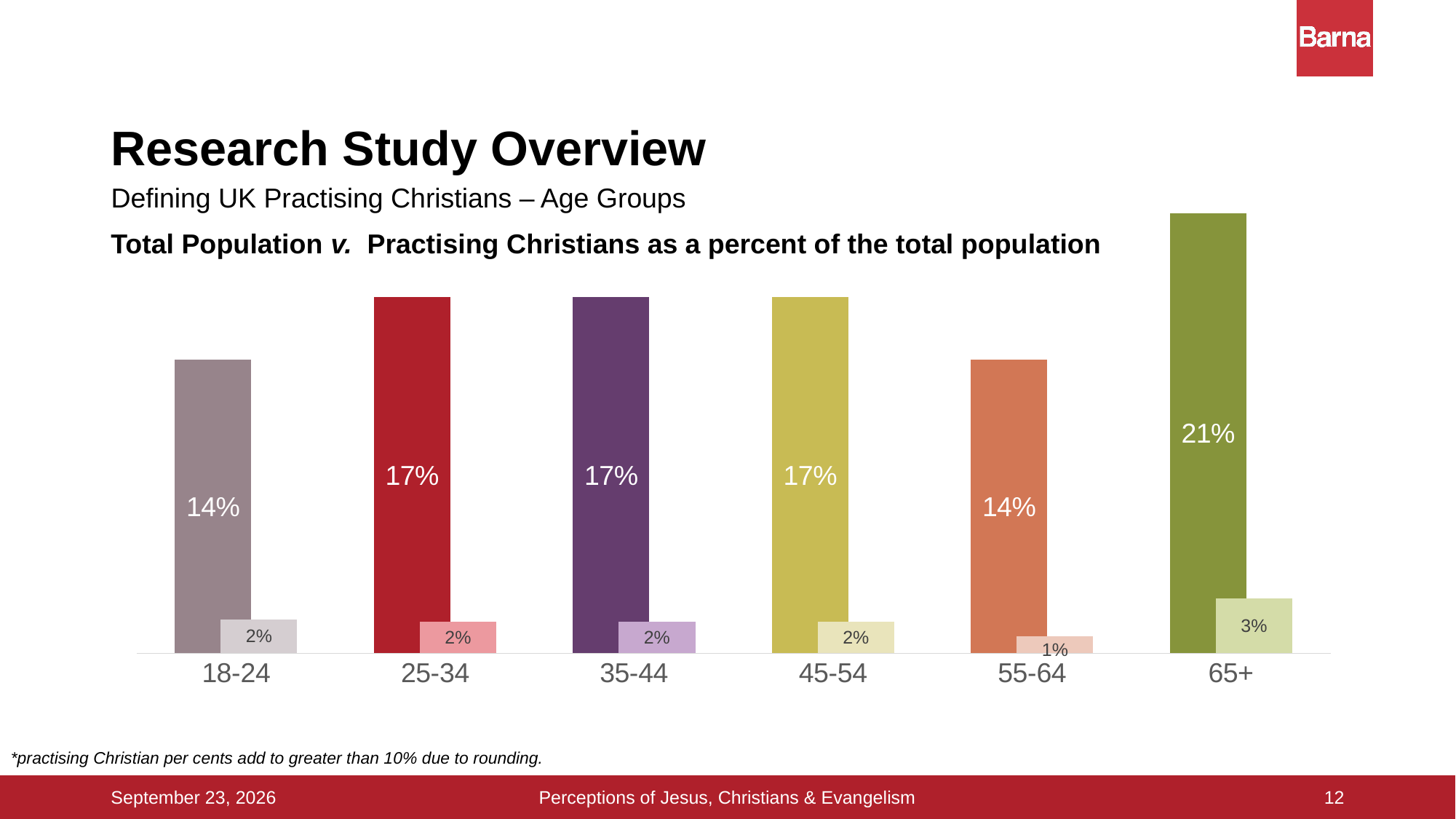
Which age group has the lowest practising Christians share? 55-64 What is the difference between the total population values for 25-34 and 18-24? 3% What is the total population value for the 18-24 age group? 14% What is the difference between the total population value and the practising Christians value for the 65+ age group? 18% What is the practising Christians value for the 55-64 age group? 1% What is the subtitle of the chart on the slide? Total Population v. Practising Christians as a percent of the total population What is the practising Christians value for the 65+ age group? 3% Which is larger, the total population value for 65+ or for 45-54? 65+ What is the total population value for the 65+ age group? 21% How many age groups are shown on the x axis? 6 What kind of chart is shown on the slide? Bar chart Which age group has the highest total population share? 65+